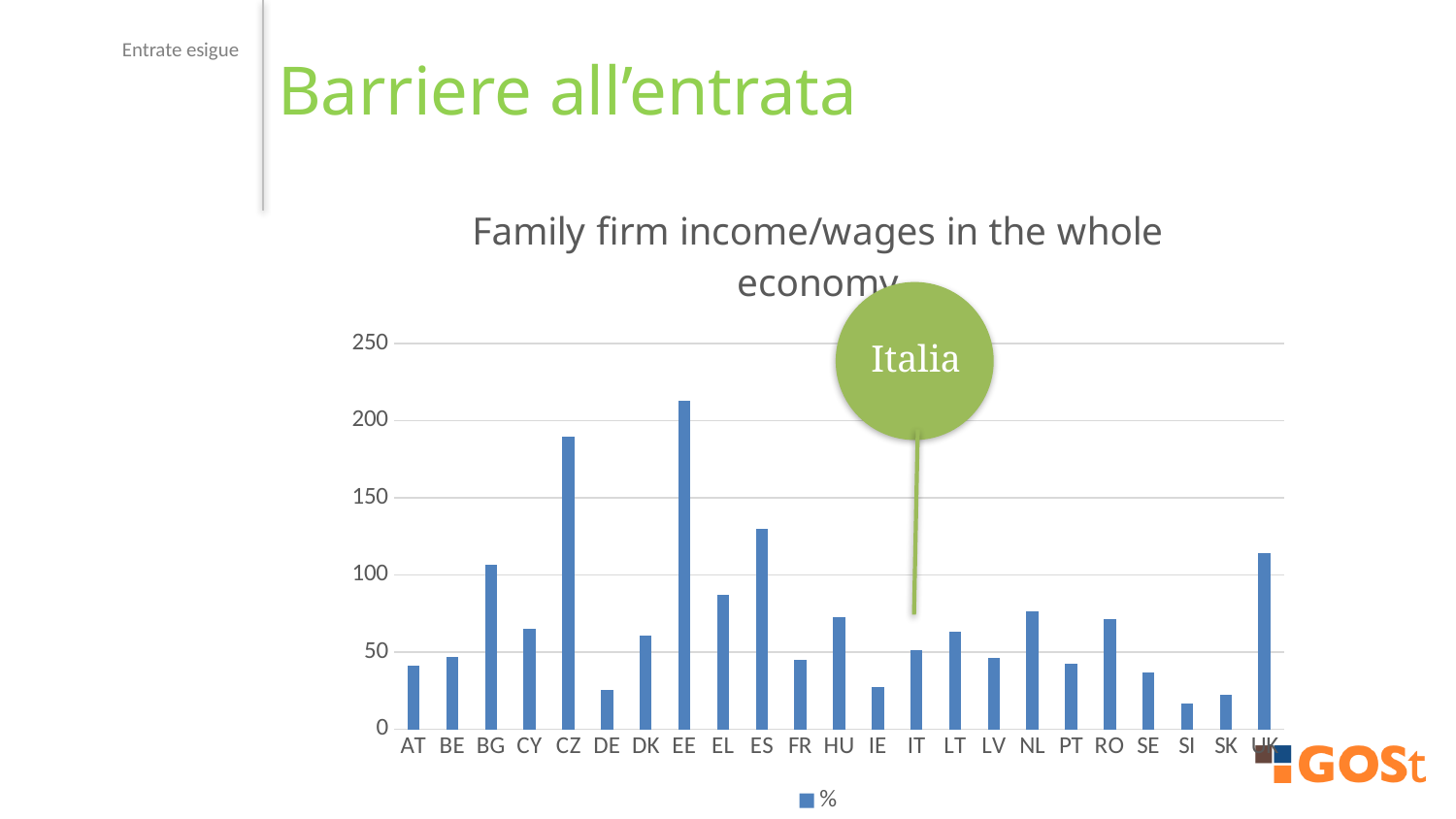
Is the value for EE greater or less than 200? greater Which country has the highest bar in the chart? EE Which has the larger value, HU or IT? HU Which country has the lowest bar in the chart? SI What kind of chart is shown on the slide? bar chart What is the legend entry shown below the chart? % Is the value for ES greater or less than 100? greater How many series does the chart legend list? 1 How many countries (categories) are shown on the x axis of the chart? 23 What is the title of the chart? Family firm income/wages in the whole economy Which has the larger value, CZ or ES? CZ Is the value for CZ greater or less than 200? less